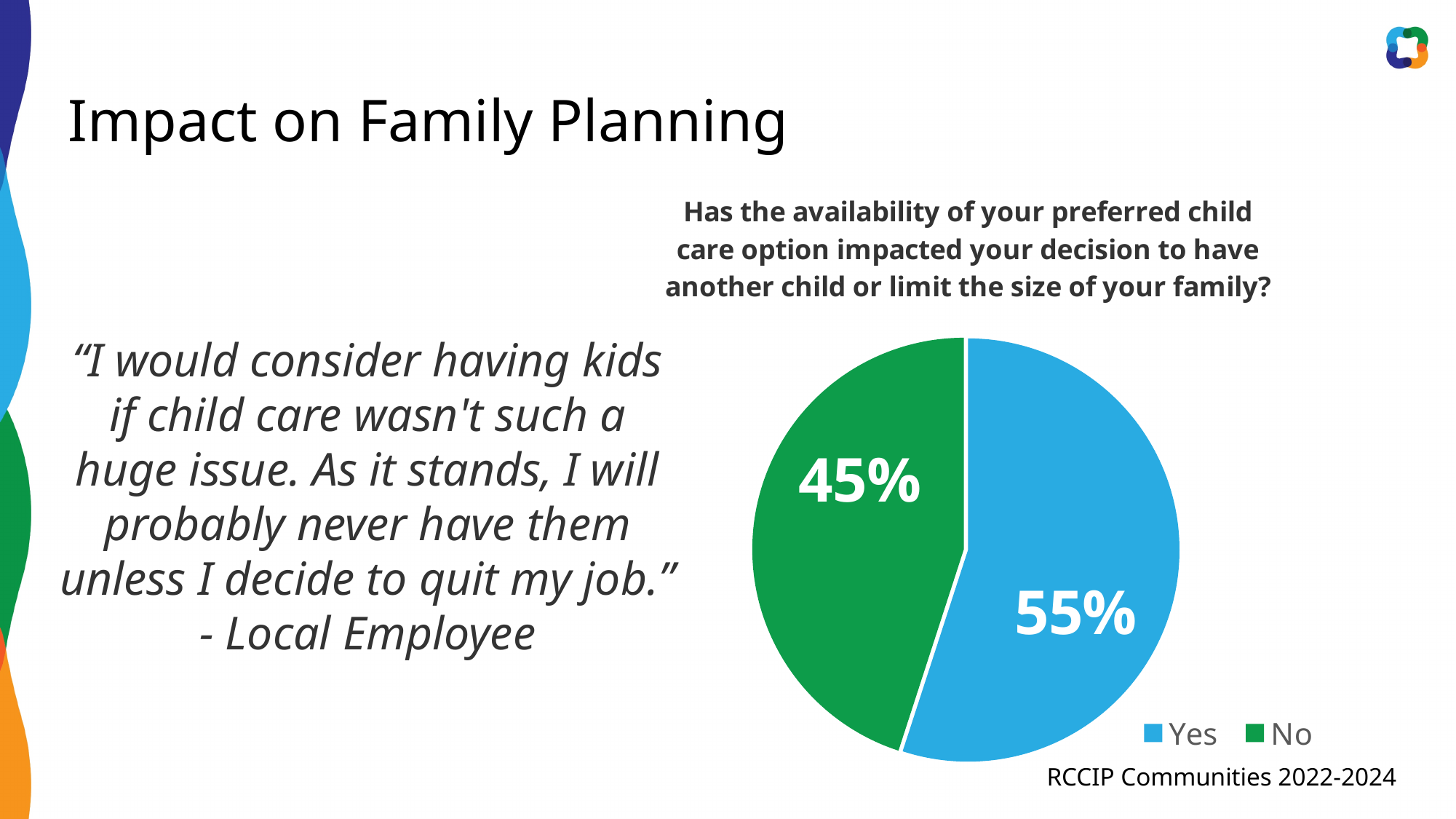
What kind of chart is shown on the slide? pie chart Is the share for Yes larger or smaller than the share for No? larger What percentage of respondents answered No? 45% What is the difference in percentage points between the Yes and No shares? 10 percentage points How many slices does the pie chart have? 2 What colour is the Yes slice of the pie chart? blue What percentage of respondents answered Yes? 55% Which response has the larger share of the pie? Yes What share of the pie does the No slice represent? 45% Which response has the smaller share of the pie? No How many entries does the legend list? 2 What source is cited below the pie chart? RCCIP Communities 2022-2024